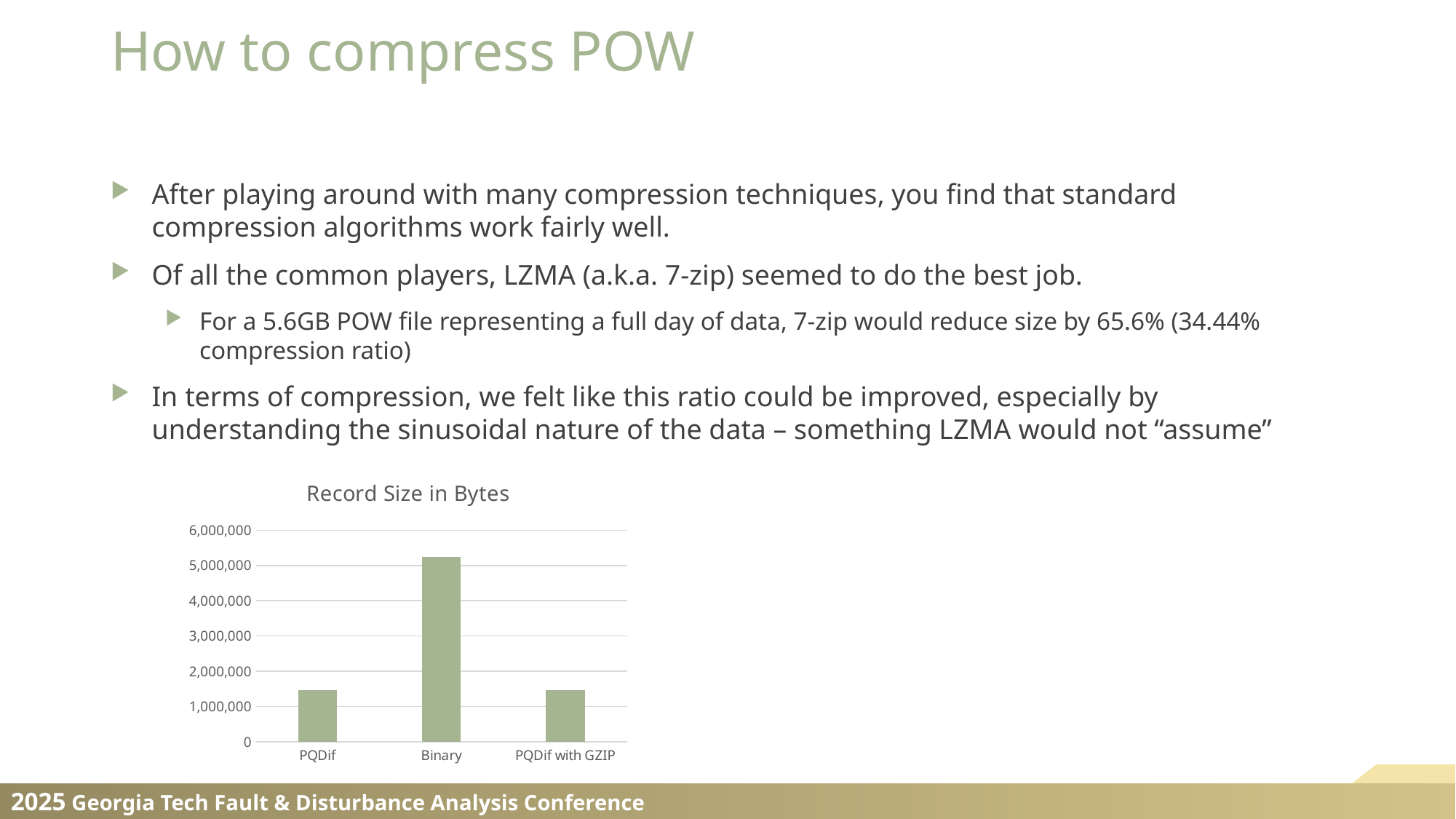
Which category has the largest record size in the chart? Binary Which has a larger record size, PQDif with GZIP or Binary? Binary Is the record size for Binary greater or less than 5,000,000 bytes? greater Which has a larger record size, Binary or PQDif? Binary Is the record size for PQDif with GZIP greater or less than 1,000,000 bytes? greater What is the title of the chart? Record Size in Bytes Is the record size for PQDif greater or less than 2,000,000 bytes? less What kind of chart is shown on the slide? bar chart How many categories are plotted in the Record Size in Bytes chart? 3 What is the highest value shown on the y axis of the chart? 6,000,000